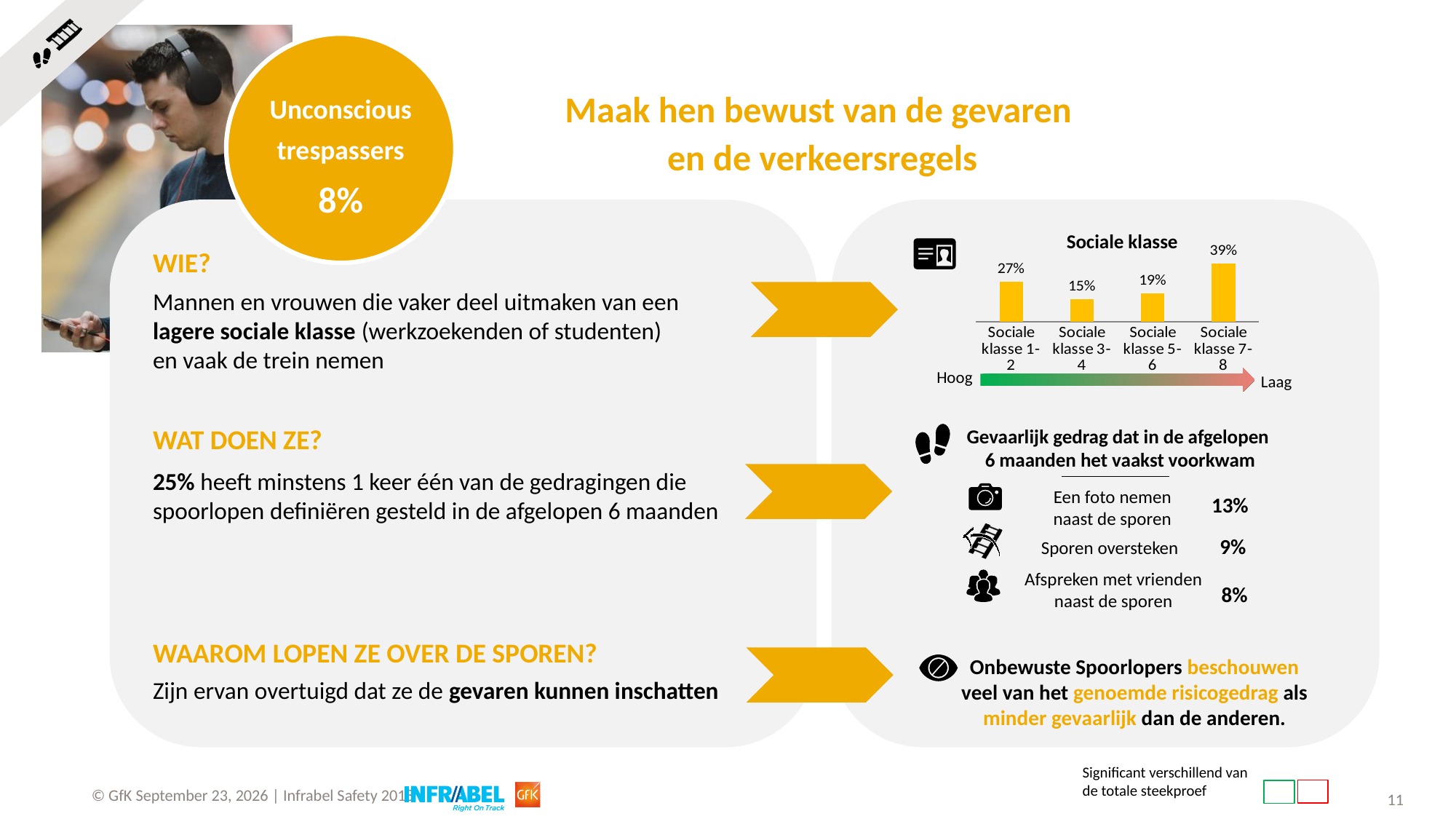
What is the title of the chart on the slide? Sociale klasse What is the value for Sociale klasse 1-2 in the Sociale klasse chart? 27% What is the difference between the values for Sociale klasse 5-6 and Sociale klasse 3-4 in the Sociale klasse chart? 4% What kind of chart is the Sociale klasse chart? Bar chart What is the difference between the values for Sociale klasse 7-8 and Sociale klasse 1-2 in the Sociale klasse chart? 12% Which category has the highest value in the Sociale klasse chart? Sociale klasse 7-8 What is the value for Sociale klasse 5-6 in the Sociale klasse chart? 19% How many categories are shown in the Sociale klasse chart? 4 What is the value for Sociale klasse 3-4 in the Sociale klasse chart? 15% In the Sociale klasse chart, which is larger: the value for Sociale klasse 1-2 or Sociale klasse 5-6? Sociale klasse 1-2 Which category has the lowest value in the Sociale klasse chart? Sociale klasse 3-4 What is the value for Sociale klasse 7-8 in the Sociale klasse chart? 39%